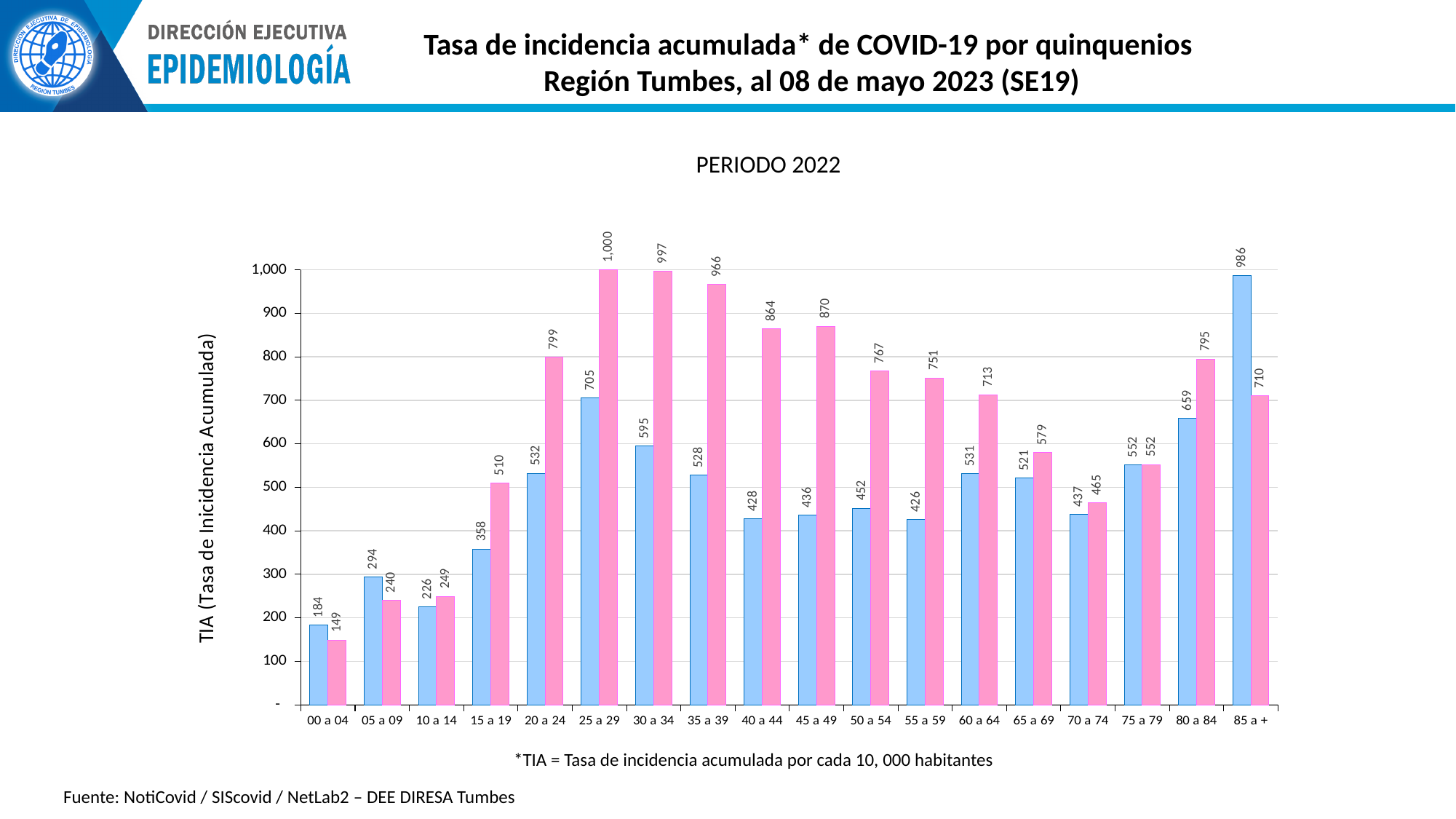
What is the value of the blue bar for the 85 a + age group? 986 What is the value of the blue bar for the 25 a 29 age group? 705 What kind of chart is shown on the slide? bar chart How many age groups are shown on the x axis? 18 What is the title shown above the chart? PERIODO 2022 What is the difference between the pink bar and the blue bar for the 20 a 24 age group? 267 For the 85 a + age group, which is larger, the blue bar or the pink bar? the blue bar Which age group has the lowest pink bar? 00 a 04 Which age group has the lowest blue bar? 00 a 04 Is the value of the pink bar for the 30 a 34 age group greater or less than 900? greater Which age group has the highest pink bar? 25 a 29 What is the value of the pink bar for the 40 a 44 age group? 864